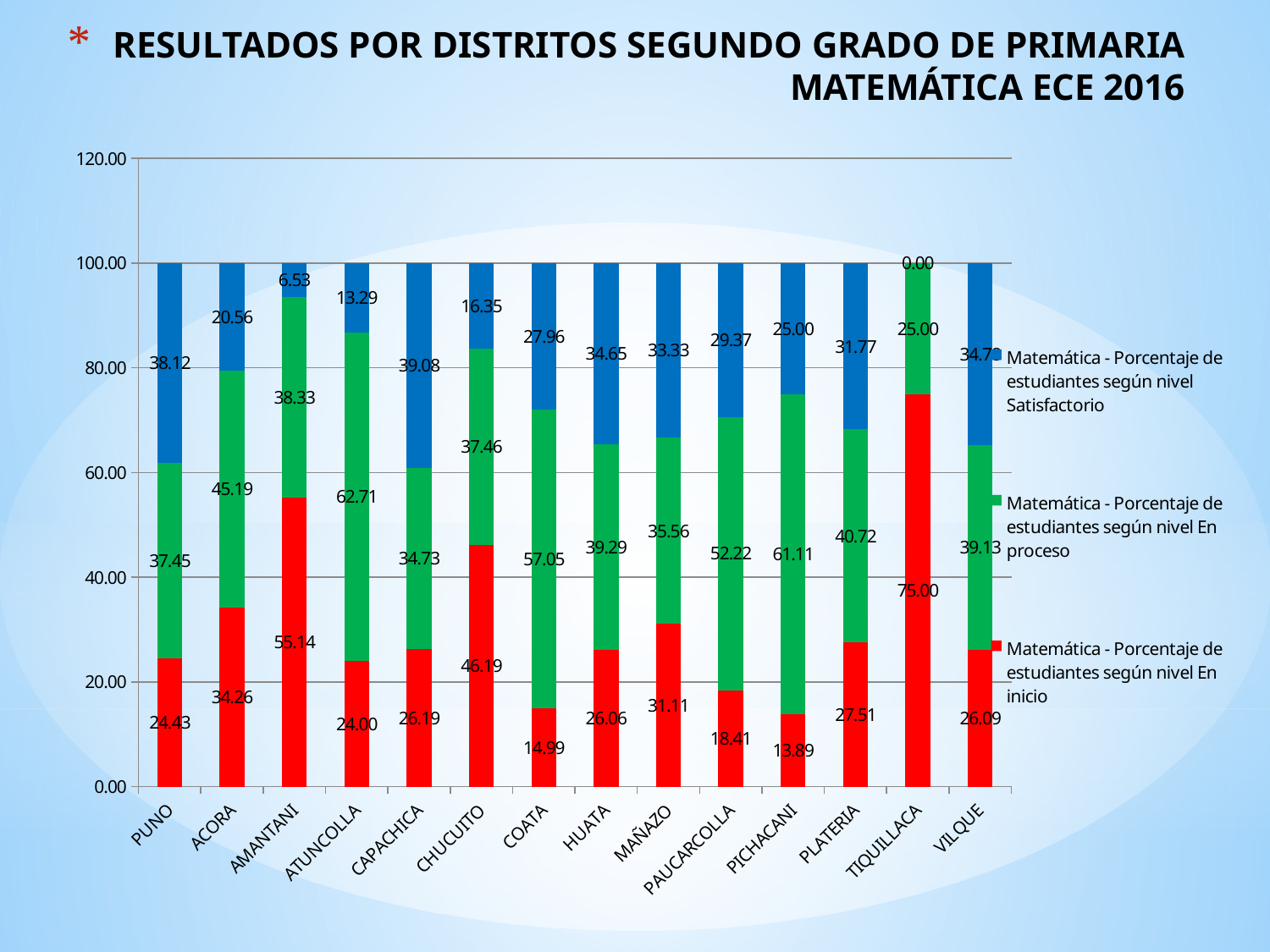
Is the En inicio value for COATA greater or less than 20.00? less What is the Satisfactorio percentage for PUNO? 38.12 Which district has the highest En inicio percentage? TIQUILLACA How many series does the legend list? 3 Which district has the lowest En inicio percentage? PICHACANI How many districts are shown on the x axis? 14 Which district has the lowest Satisfactorio percentage? TIQUILLACA What is the En inicio percentage for TIQUILLACA? 75.00 Which district has a larger En inicio percentage, CHUCUITO or AMANTANI? AMANTANI What is the difference between the En proceso and Satisfactorio percentages for ACORA? 24.63 What kind of chart is shown on the slide? Stacked bar chart What is the En proceso percentage for ATUNCOLLA? 62.71